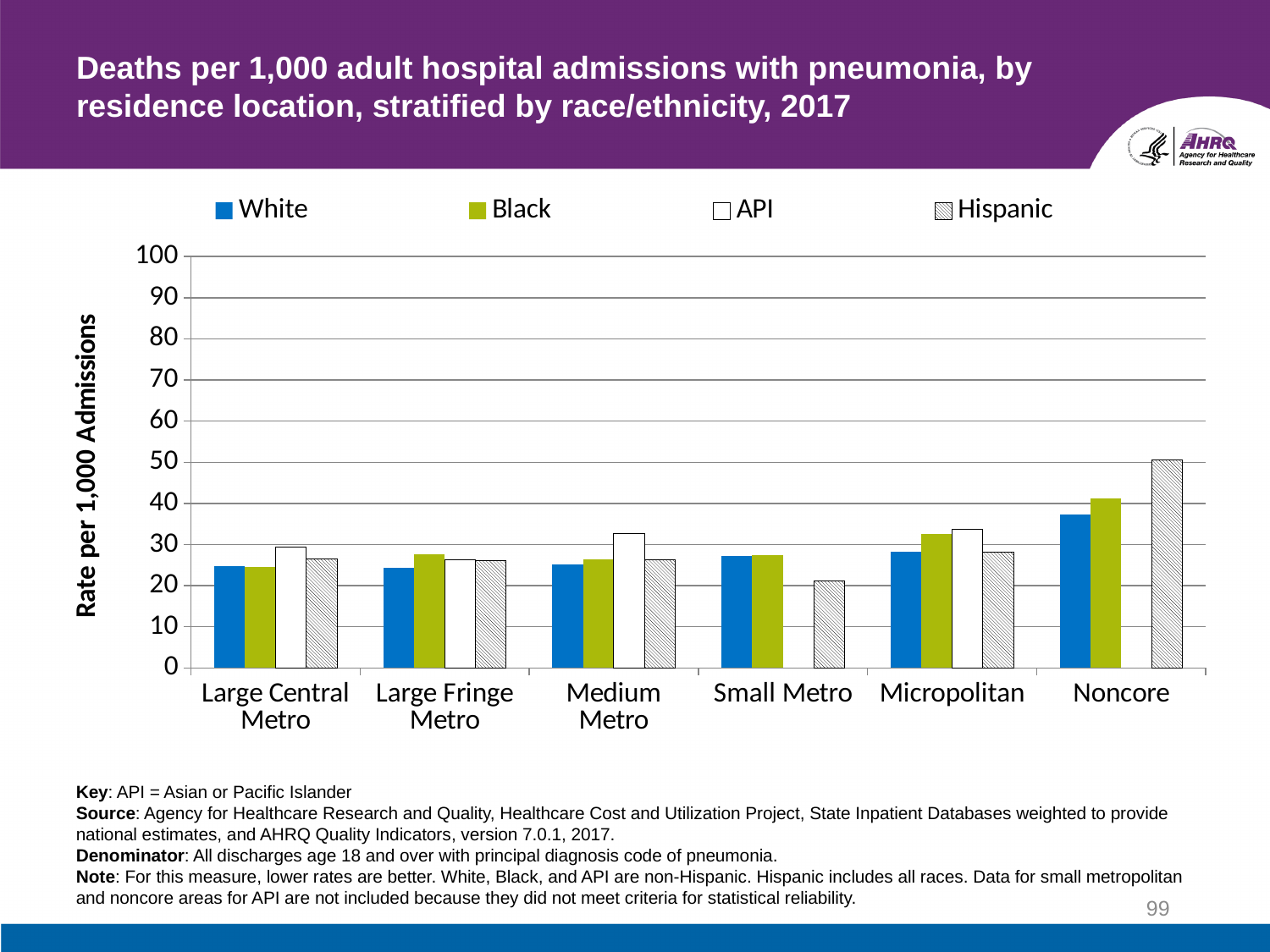
Is the Hispanic value for Noncore greater or less than 40? greater How many residence location categories are shown on the x axis? 6 How many race/ethnicity series does the legend list? 4 Is the White value for Noncore greater or less than 30? greater In Noncore, which is larger, the White rate or the Hispanic rate? Hispanic Which residence location has the highest rate for Hispanic? Noncore What kind of chart is shown on the slide? Bar chart Which residence location has the lowest rate for Hispanic? Small Metro Is the Hispanic value for Small Metro greater or less than 30? less In Medium Metro, which is larger, the White rate or the API rate? API Which residence locations have no API bar shown? Small Metro and Noncore What is the label of the y axis? Rate per 1,000 Admissions